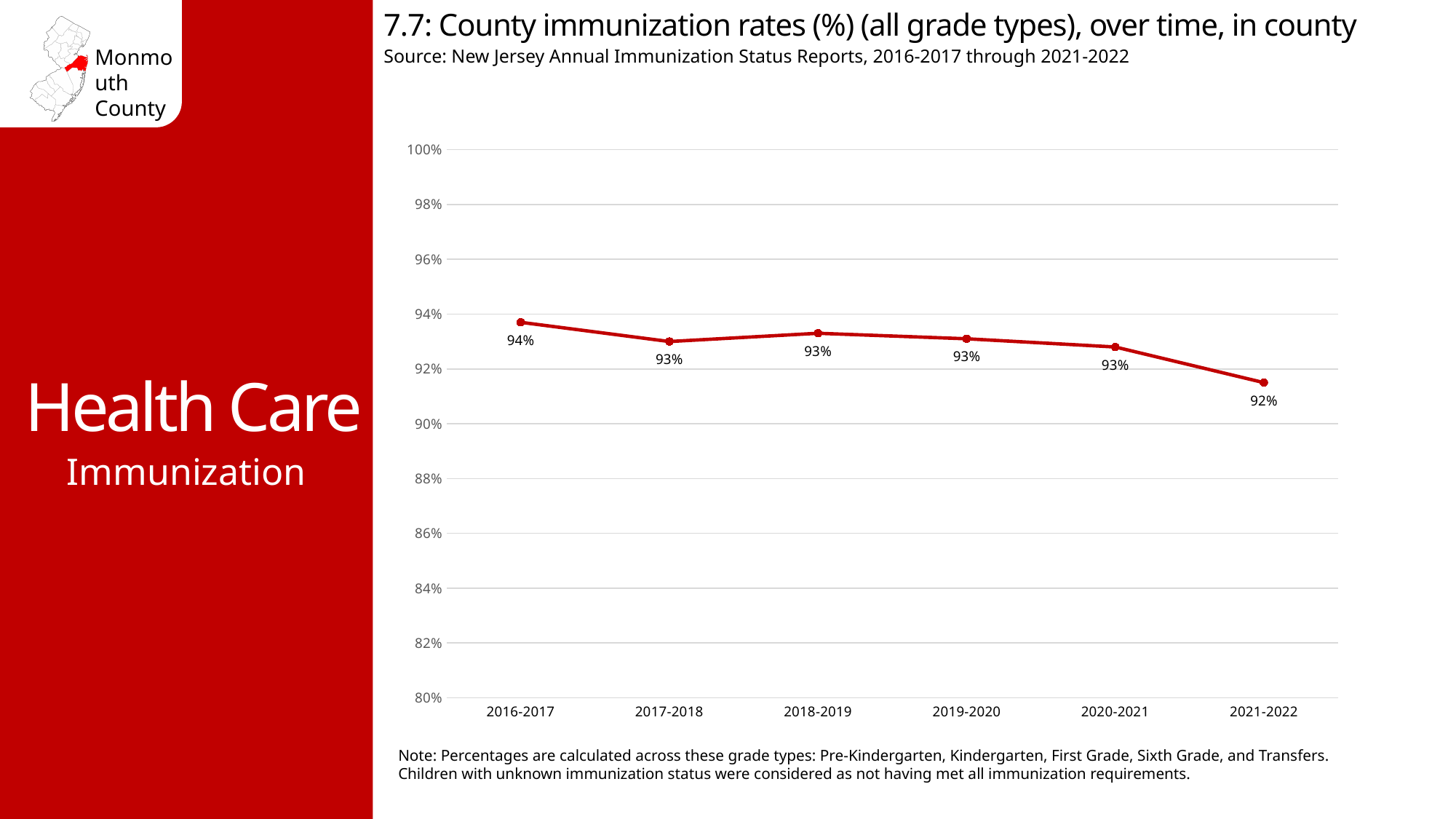
Do the immunization rates rise or fall from 2016-2017 to 2021-2022? Fall What was the county immunization rate in 2018-2019? 93% What was the county immunization rate in 2021-2022? 92% Which school year had the highest immunization rate? 2016-2017 Which year had a higher immunization rate, 2016-2017 or 2021-2022? 2016-2017 Which school year had the lowest immunization rate? 2021-2022 What kind of chart is shown on the slide? Line chart What is the source of the data shown in the chart? New Jersey Annual Immunization Status Reports, 2016-2017 through 2021-2022 Is the immunization rate for 2020-2021 greater or less than 90%? greater What was the county immunization rate in 2016-2017? 94% How many school years are plotted on the chart? 6 What is the difference in immunization rate between 2016-2017 and 2021-2022? 2 percentage points